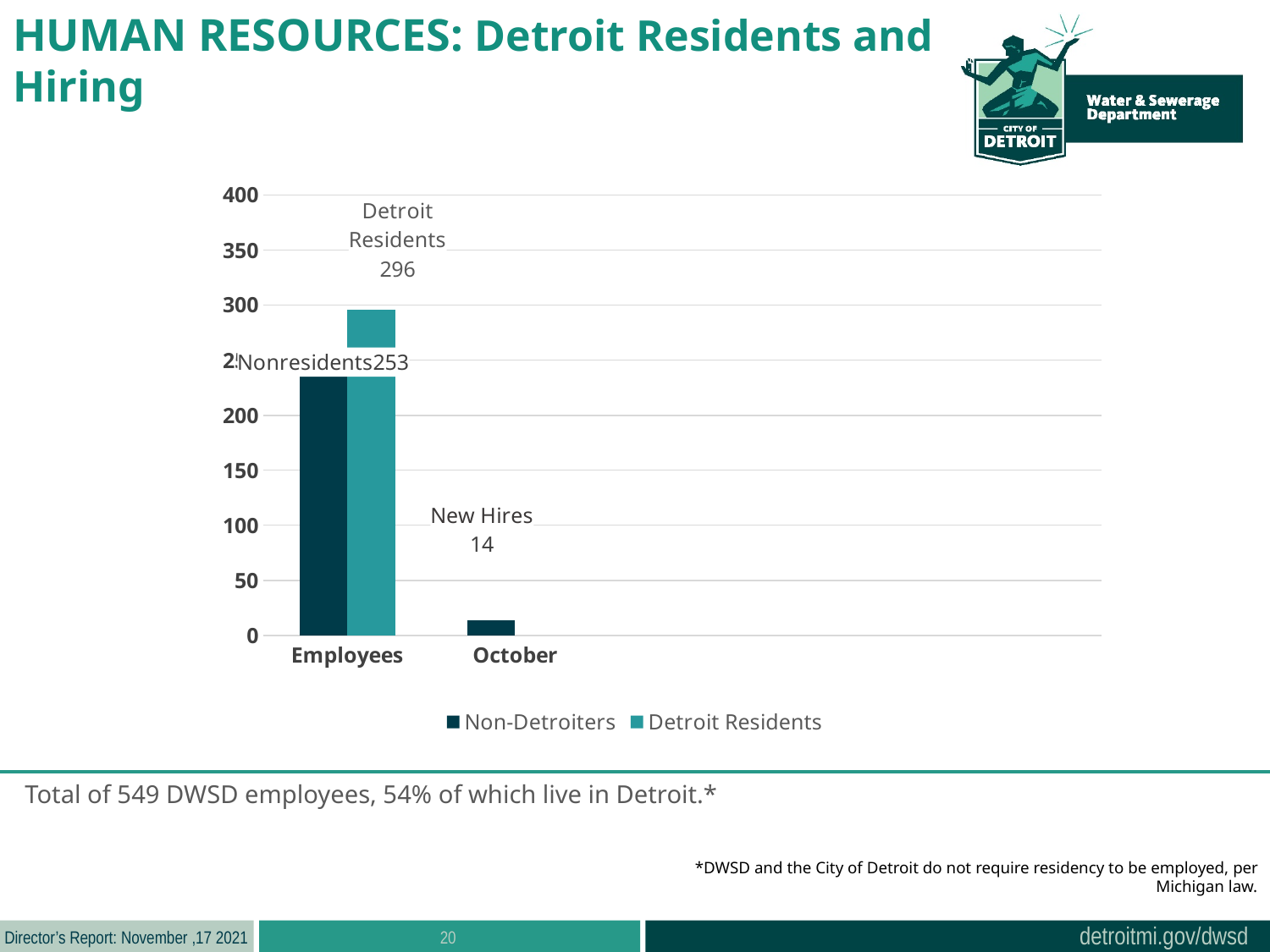
What is the value of the New Hires bar in the October category? 14 What is the difference between Detroit Residents and Non-Detroiters in the Employees category? 43 What kind of chart is shown on the slide? bar chart How many series does the legend list? 2 Is the value for Non-Detroiters in the Employees category greater or less than 200? greater How many categories are shown on the x axis? 2 What is the value for Non-Detroiters in the Employees category? 253 What is the value for Detroit Residents in the Employees category? 296 What are the two legend entries of the chart? Non-Detroiters and Detroit Residents Which bar in the chart is the lowest? New Hires (October) In the Employees category, which is larger: Non-Detroiters or Detroit Residents? Detroit Residents Is the value for New Hires in October greater or less than 50? less